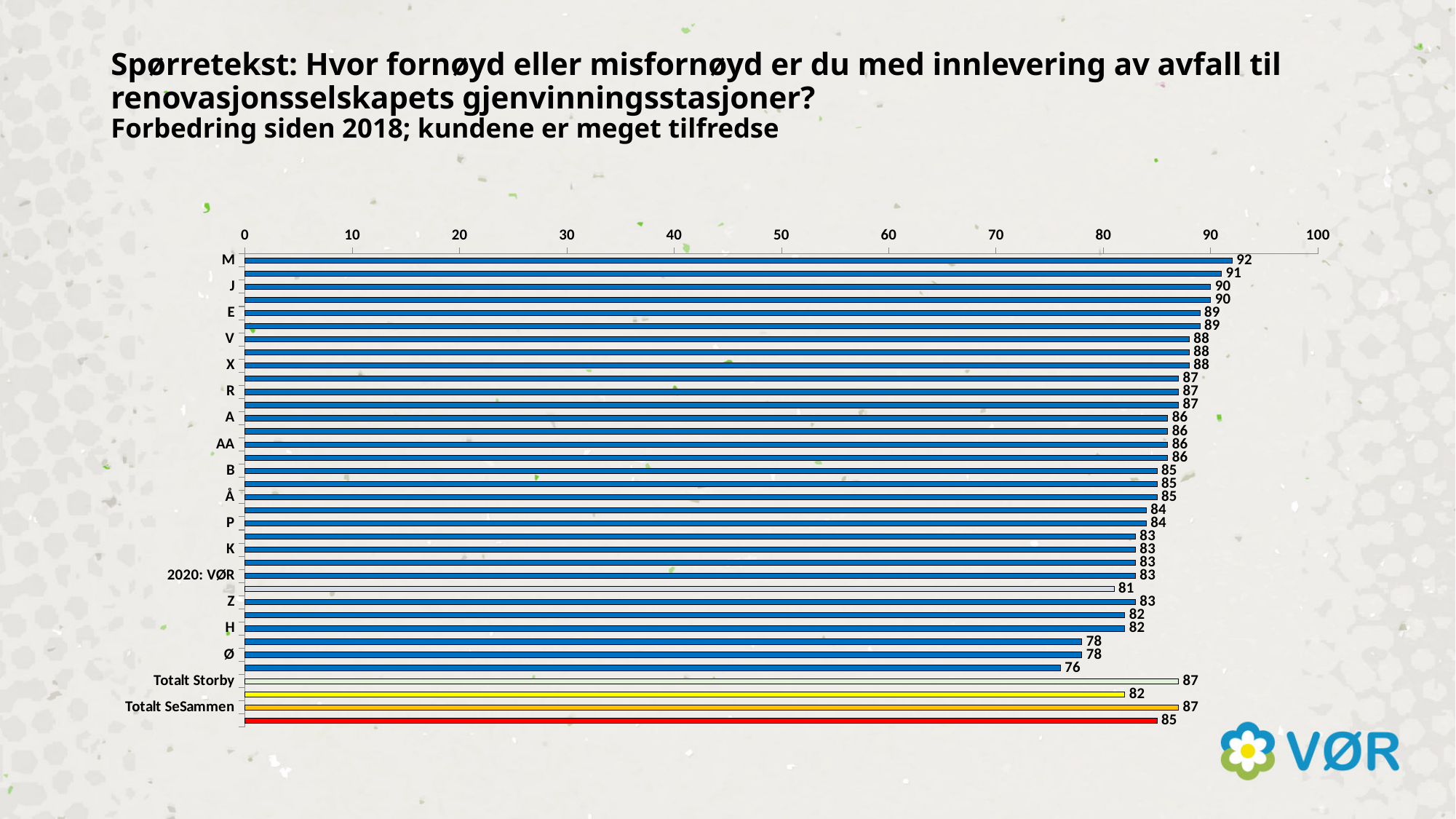
Is the value for Ø greater or less than 80? less Which labelled category has the highest value? M What is the value for Totalt Storby? 87 What kind of chart is shown on the slide? bar chart What is the value for M? 92 What is the value of the red bar at the bottom of the chart? 85 What is the lowest value shown on any bar in the chart? 76 What is the value for Ø? 78 Which is larger, the value for J or the value for E? J What is the value for Totalt SeSammen? 87 What is the value for J? 90 What is the difference between the values for M and Ø? 14